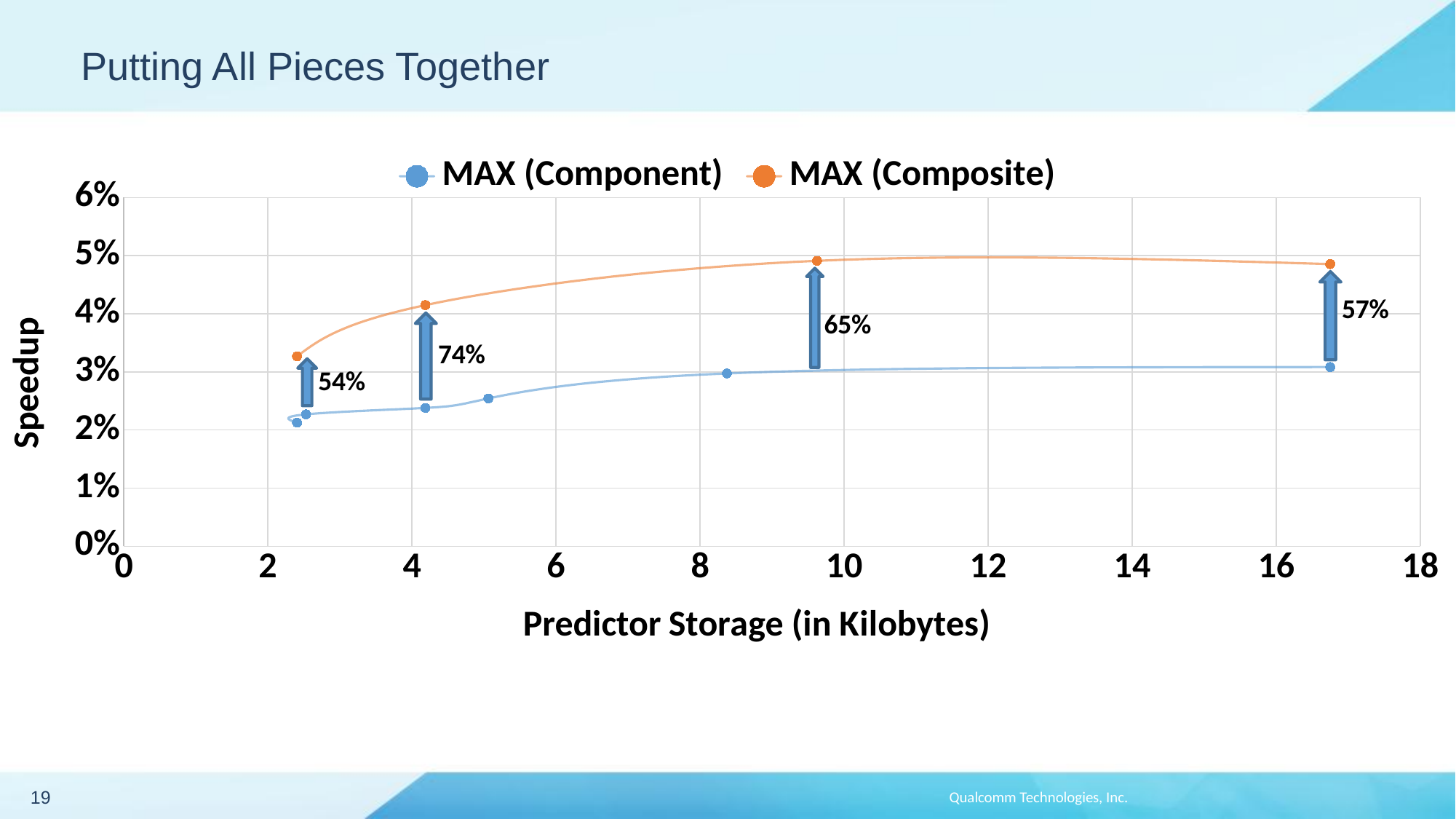
Is the MAX (Component) speedup at about 4 KB of predictor storage greater or less than 3%? less What percentage is printed next to the arrow at about 17 KB of predictor storage? 57% What are the two series named in the legend? MAX (Component) and MAX (Composite) How many series does the legend list? 2 What percentage is printed next to the arrow at about 4 KB of predictor storage? 74% At about 4 KB of predictor storage, which series has the higher speedup, MAX (Component) or MAX (Composite)? MAX (Composite) Is the MAX (Composite) speedup at about 10 KB of predictor storage greater or less than 4%? greater How many data points are plotted for the MAX (Component) series? 6 What type of chart is shown on the slide? line chart What is the title of the x axis? Predictor Storage (in Kilobytes) Does the MAX (Composite) speedup rise or fall as predictor storage increases from 2 KB to 10 KB? rise How many data points are plotted for the MAX (Composite) series? 4